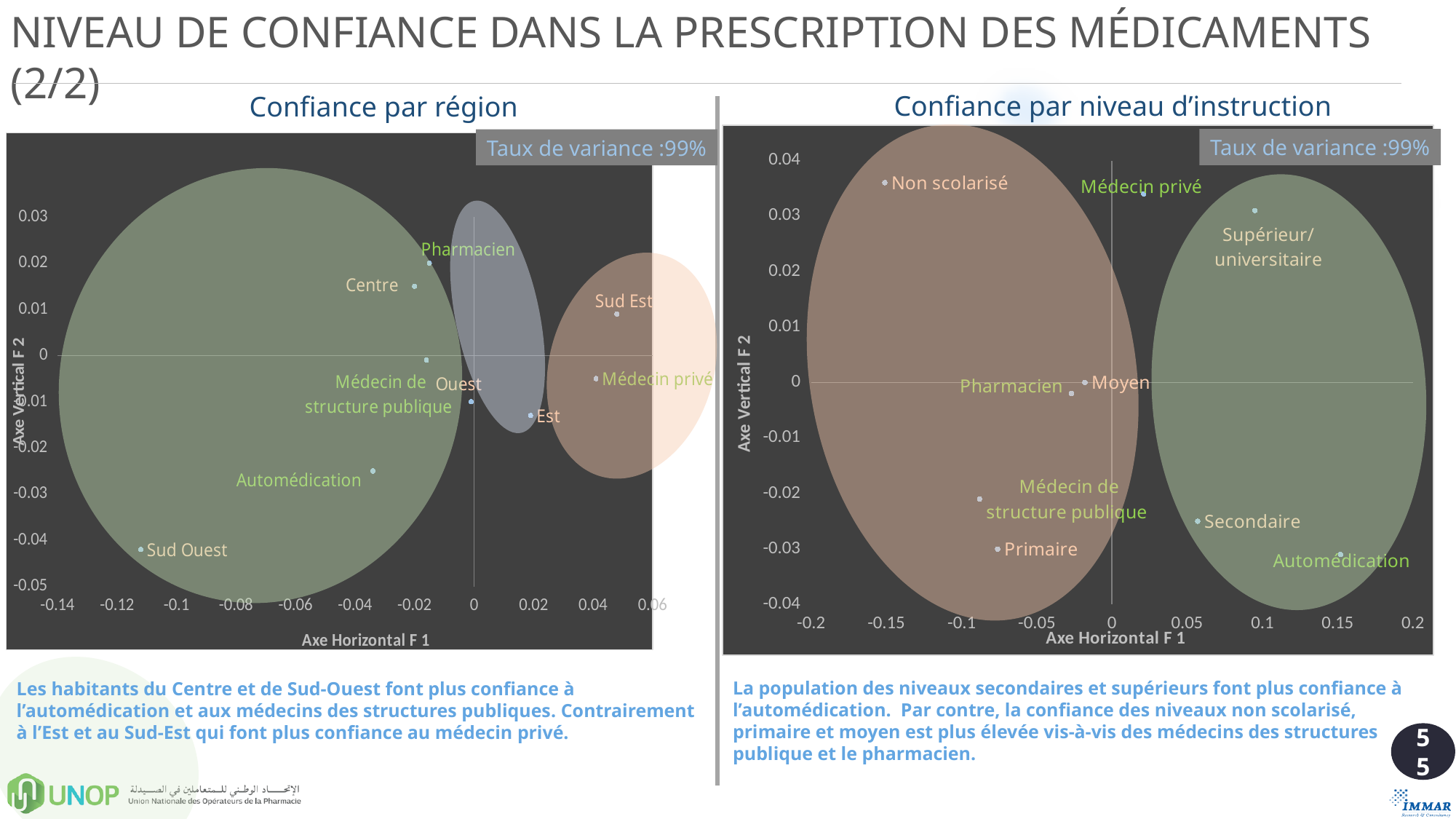
On the 'Confiance par région' chart, which point has the lowest value on the horizontal axis (Axe Horizontal F 1)? Sud Ouest On the 'Confiance par niveau d'instruction' chart, which point has the highest value on the horizontal axis (Axe Horizontal F 1)? Automédication On the 'Confiance par niveau d'instruction' chart, is the vertical axis value for Supérieur/universitaire greater or less than 0.02? greater What kind of chart is the 'Confiance par région' chart? scatter chart On the 'Confiance par niveau d'instruction' chart, which point has the lowest value on the horizontal axis (Axe Horizontal F 1)? Non scolarisé What 'Taux de variance' is shown on the 'Confiance par région' chart? 99% On the 'Confiance par région' chart, is the horizontal axis value for Sud Ouest greater or less than -0.1? less How many labelled points are plotted on the 'Confiance par région' chart? 9 How many labelled points are plotted on the 'Confiance par niveau d'instruction' chart? 9 On the 'Confiance par région' chart, is the horizontal axis value for Sud Est greater or less than 0.04? greater